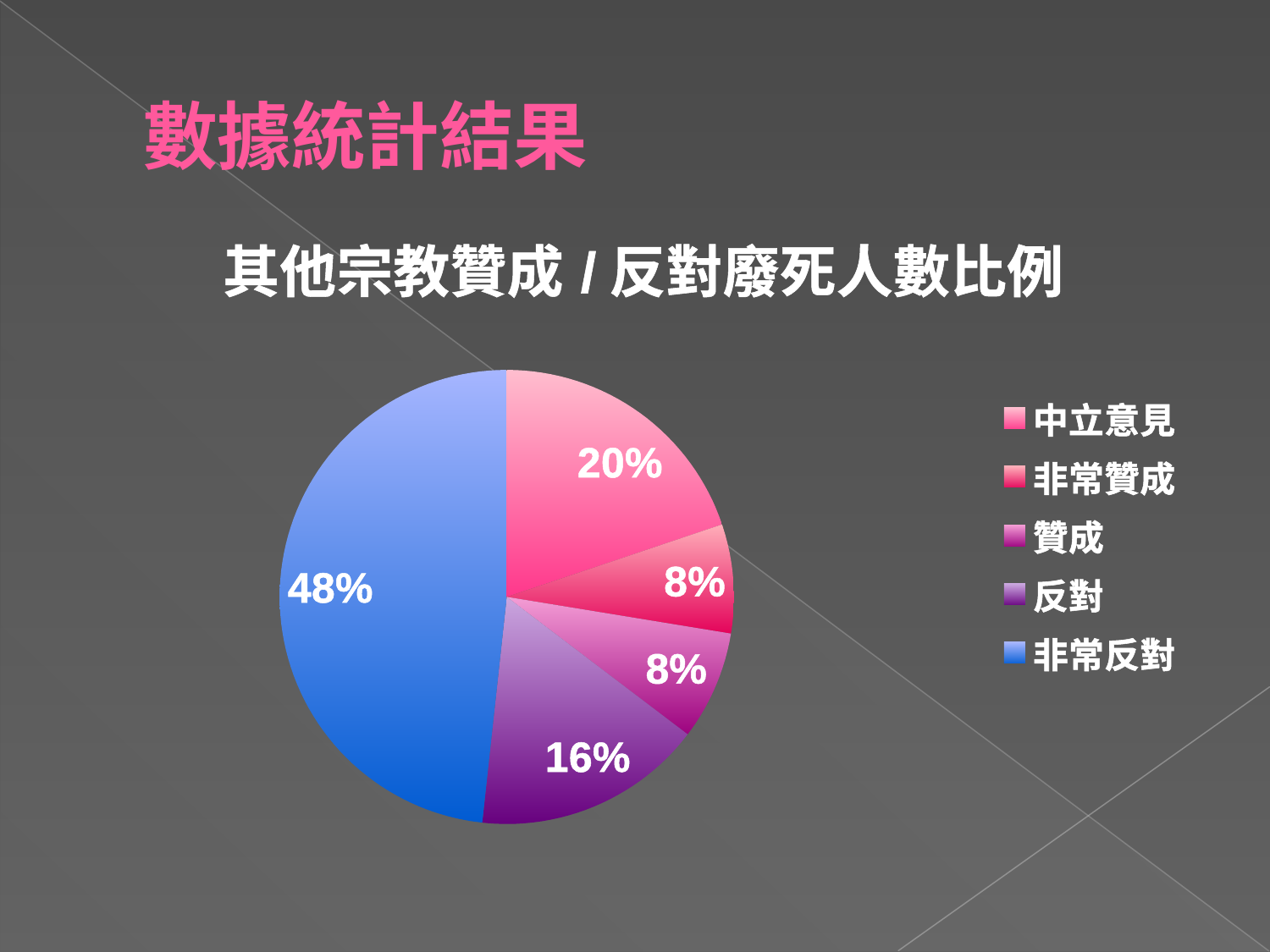
How many categories does the legend list? 5 What is the title of the chart? 其他宗教贊成 / 反對廢死人數比例 What is the value shown for 非常贊成? 8% What kind of chart is shown on the slide? Pie chart What is the difference between the 非常反對 slice and the 反對 slice? 32% Which is larger, the slice for 中立意見 or the slice for 反對? 中立意見 What is the value shown for 反對? 16% Which category is shown in blue in the legend? 非常反對 What is the value shown for 中立意見? 20% What is the difference between the 中立意見 slice and the 贊成 slice? 12% Which category has the largest slice of the pie? 非常反對 What share of the pie does 非常反對 represent? 48%